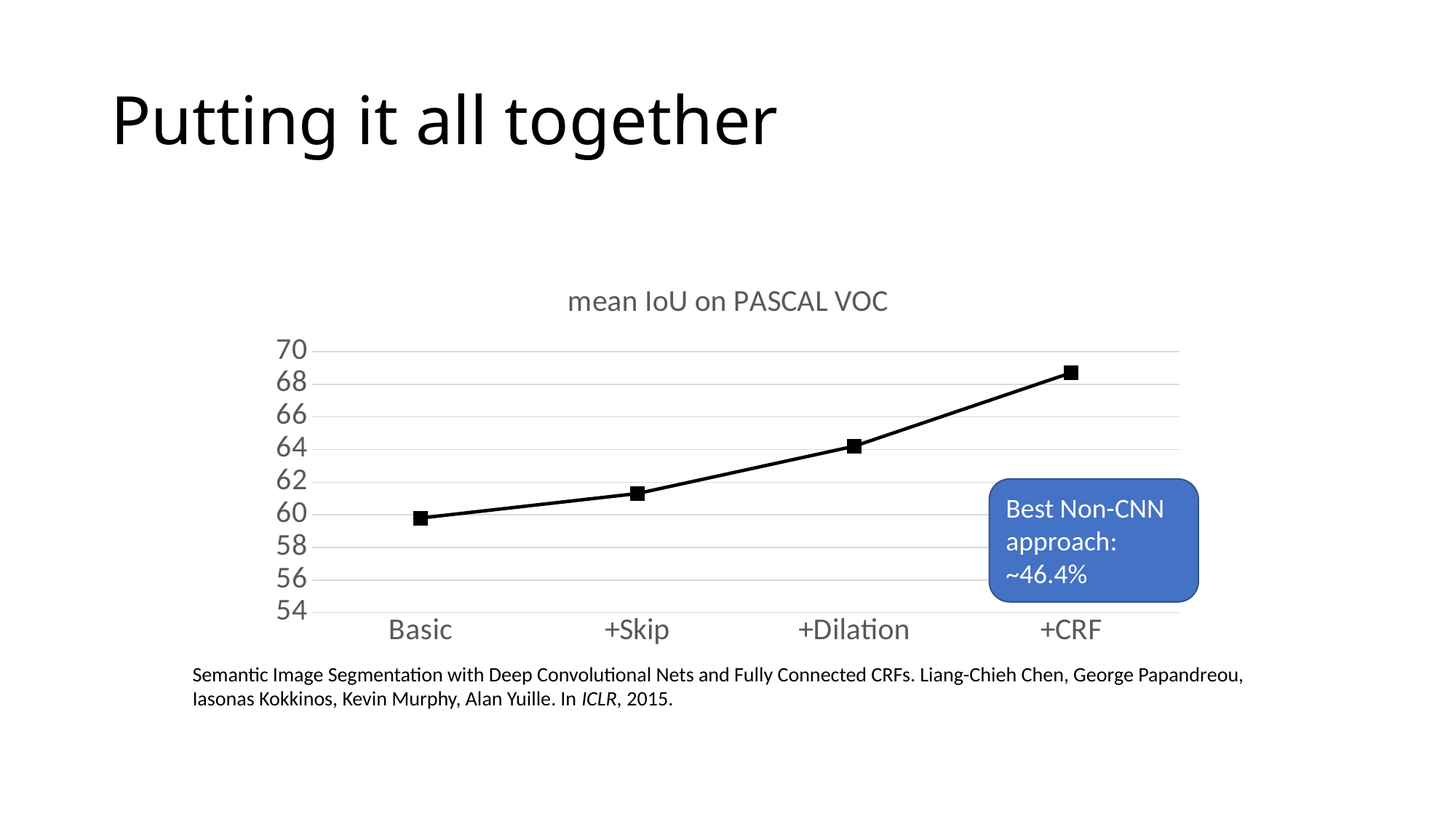
Which has a higher mean IoU, +Skip or +Dilation? +Dilation How many points are plotted on the line? 4 Do the values rise or fall from Basic to +CRF along the x axis? rise Is the value for +CRF greater or less than 70? less Is the value for +Dilation greater or less than 62? greater What kind of chart is shown on the slide? line chart Which category has the highest mean IoU? +CRF What is the title of the chart? mean IoU on PASCAL VOC According to the callout on the chart, what is the mean IoU of the best non-CNN approach? ~46.4% Is the value for +Skip greater or less than 60? greater Which category has the lowest mean IoU? Basic